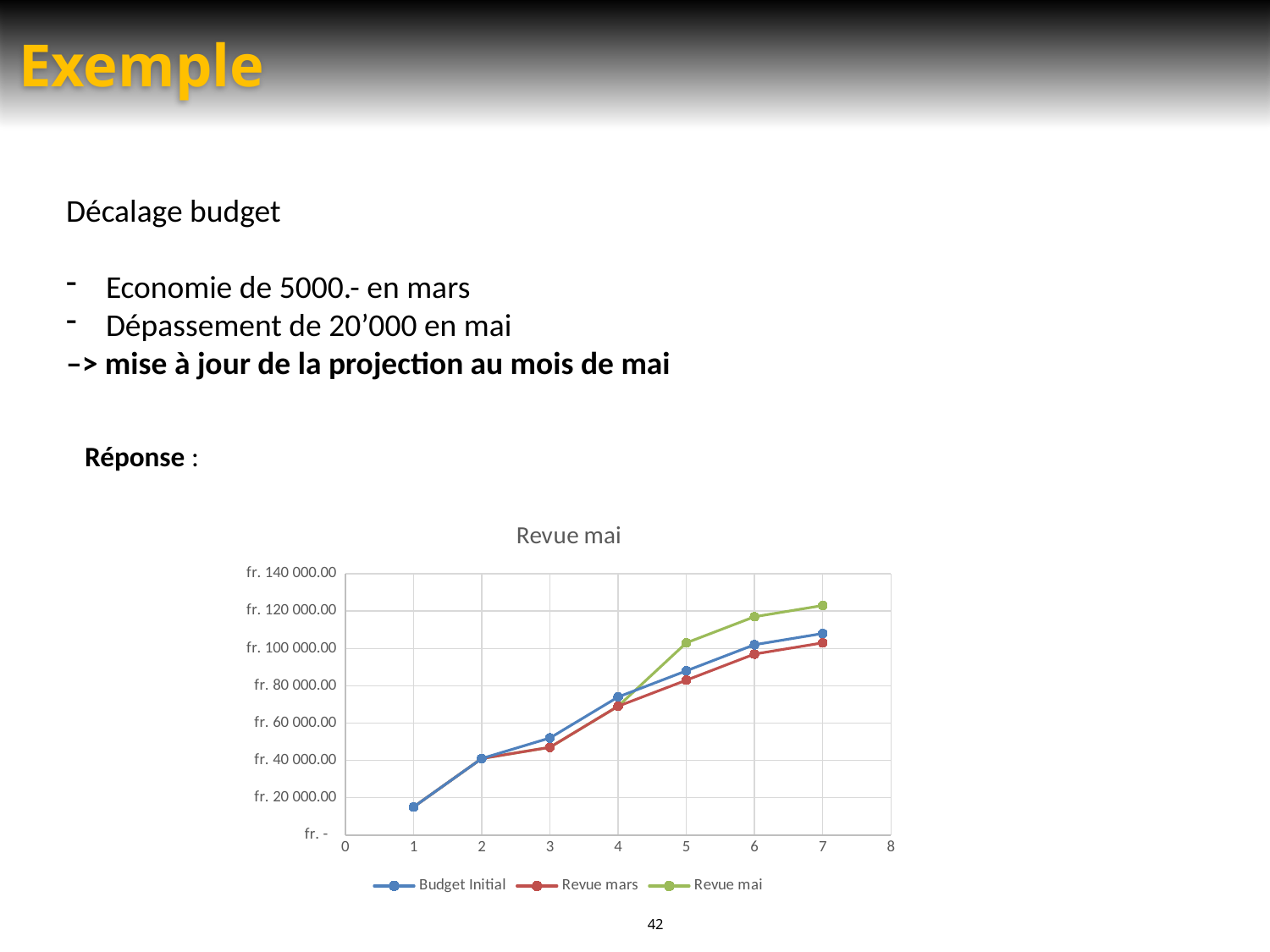
What kind of chart is shown on the slide? line chart How many series does the chart legend list? 3 Which series has the lowest value at x = 7? Revue mars Which series are listed in the chart legend? Budget Initial, Revue mars, Revue mai At x = 3, which is larger: Budget Initial or Revue mars? Budget Initial Which series has the highest value at x = 7? Revue mai Is the value of Budget Initial at x = 3 greater or less than fr. 60 000.00? less Is the value of Budget Initial at x = 1 greater or less than fr. 20 000.00? less Do the values of the Budget Initial series rise or fall along the x axis? rise What is the title of the chart? Revue mai Is the value of Budget Initial at x = 5 greater or less than fr. 80 000.00? greater